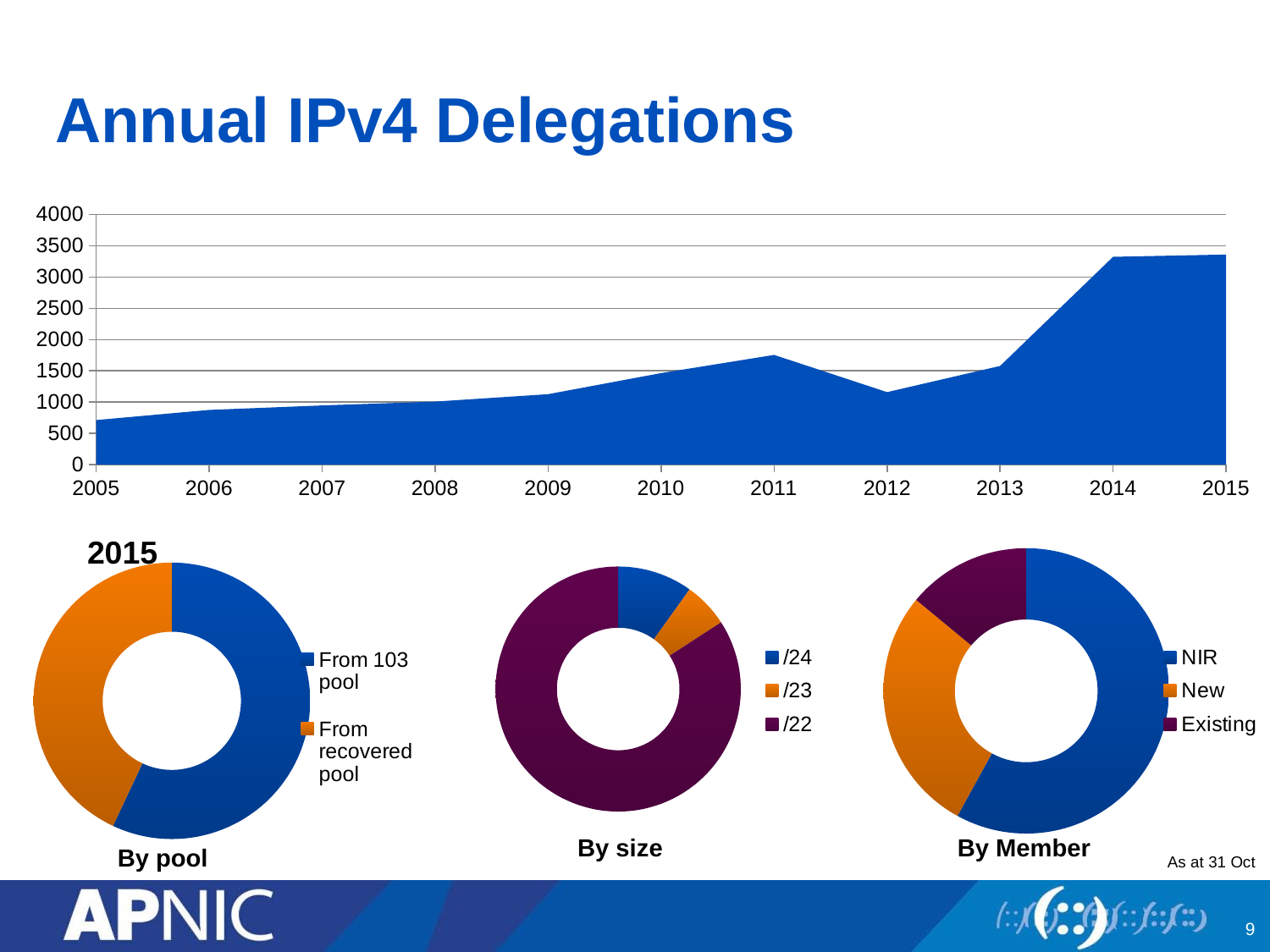
How many entries does the legend of the 'By size' doughnut chart list? 3 In the 'By pool' doughnut chart, which category has the larger share? From 103 pool In the top area chart, do the values rise or fall from 2012 to 2014? rise In the top area chart, how many years are shown on the x axis? 11 In the 'By size' doughnut chart, which category has the largest share? /22 What kind of chart is the top chart on the slide (Annual IPv4 Delegations)? area chart In the top area chart, is the value for 2005 greater or less than 1000? less In the top area chart, which is larger, the value for 2011 or the value for 2012? 2011 In the 'By Member' doughnut chart, which category has the smallest share? Existing In the top area chart, is the value for 2014 greater or less than 3000? greater In the top area chart, which year has the lowest value? 2005 In the top area chart, is the value for 2012 greater or less than 1500? less